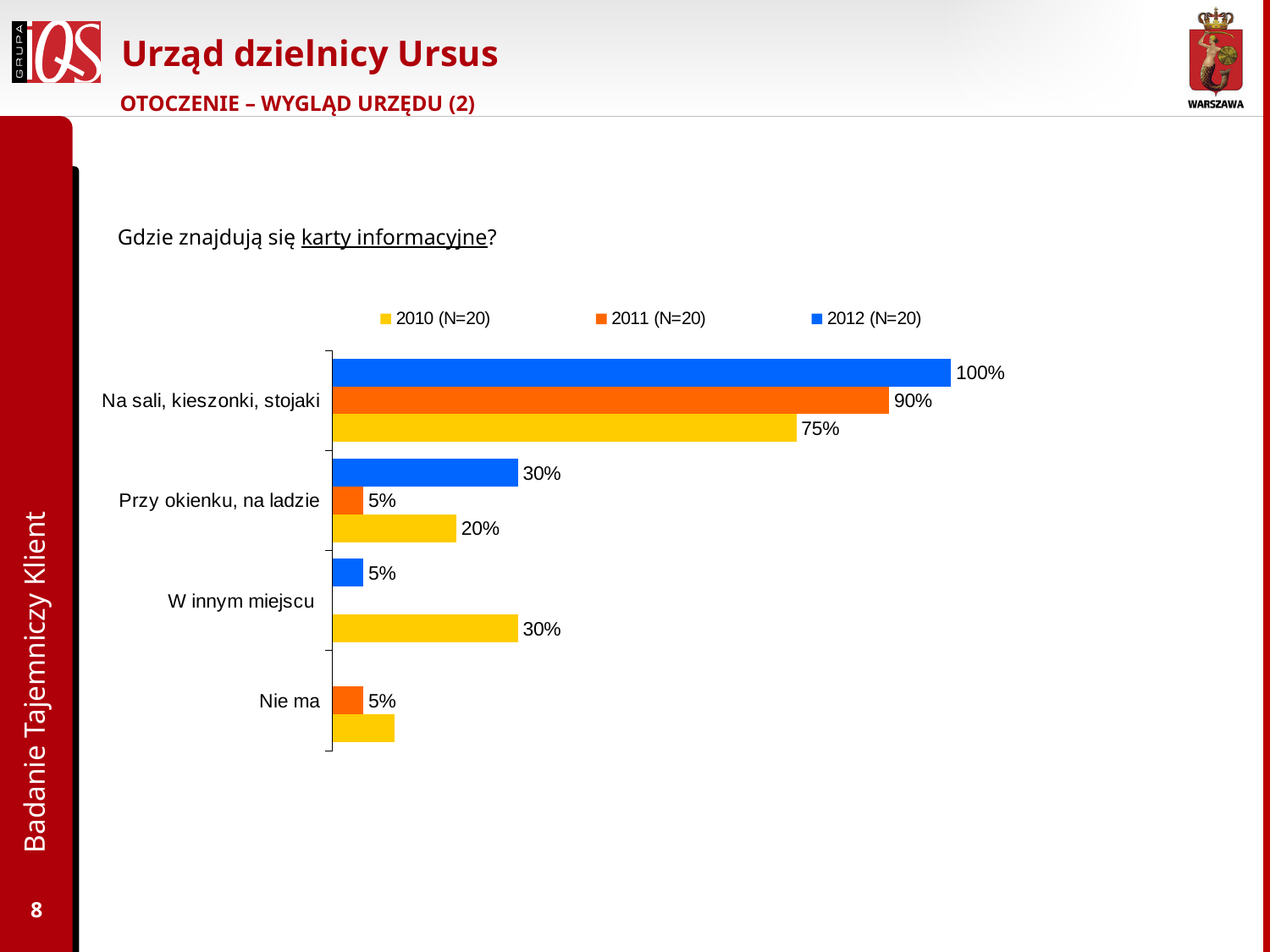
How many categories are shown on the chart? 4 Which is larger for 'Przy okienku, na ladzie': the 2012 value or the 2010 value? 2012 What kind of chart is shown on the slide? bar chart Which colour represents the 2011 (N=20) series in the legend? orange What is the value for 'Na sali, kieszonki, stojaki' in 2011 (N=20)? 90% What is the value for 'Przy okienku, na ladzie' in 2010 (N=20)? 20% Which category has the highest value for 2012 (N=20)? Na sali, kieszonki, stojaki What is the value for 'W innym miejscu' in 2012 (N=20)? 5% What is the difference between the 2010 and 2012 values for 'W innym miejscu'? 25% What is the difference between the 2012 and 2010 values for 'Na sali, kieszonki, stojaki'? 25% What is the value for 'Na sali, kieszonki, stojaki' in 2012 (N=20)? 100% How many series does the legend list? 3